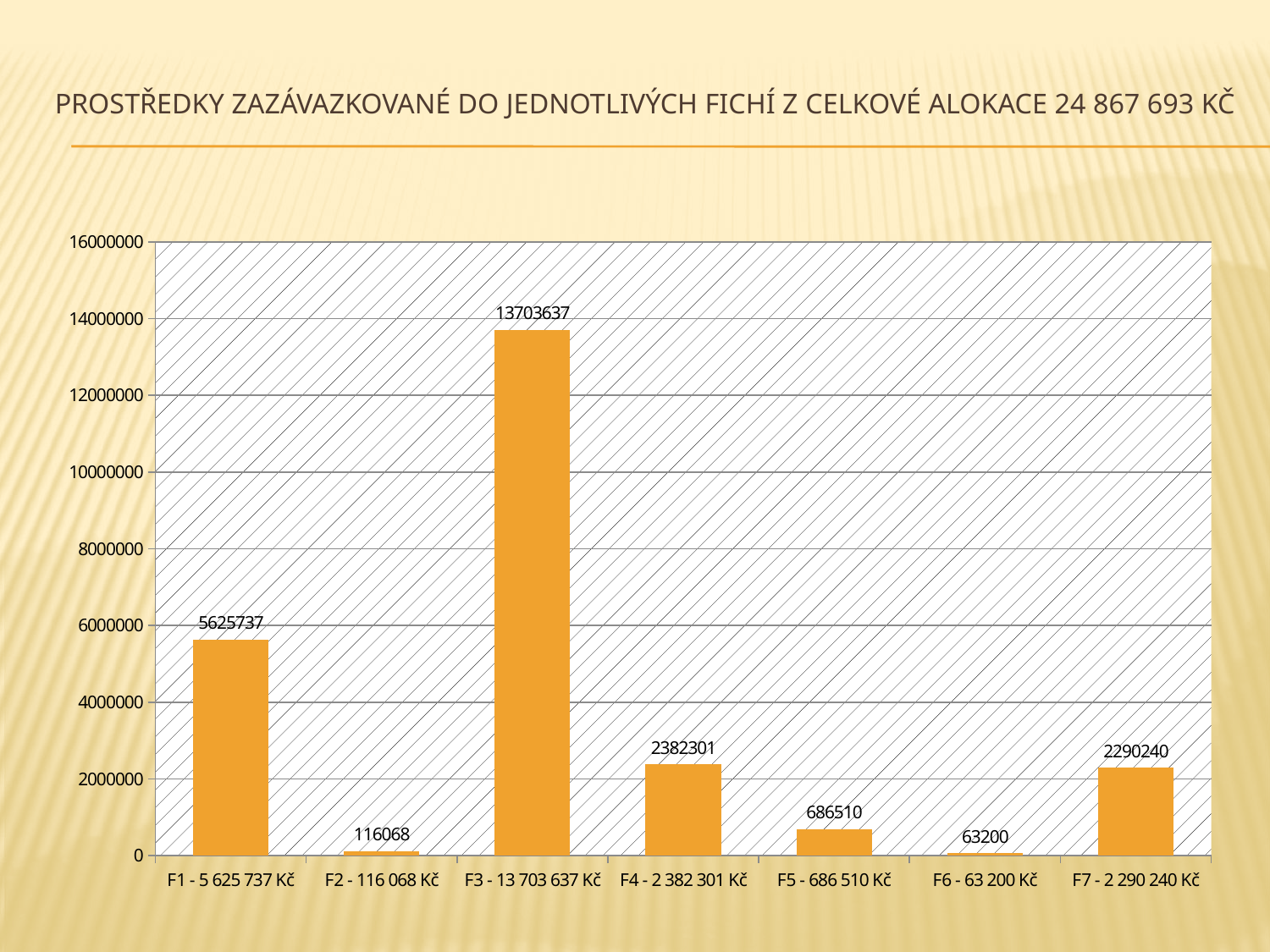
Which is larger, the value for F1 or the value for F4? F1 Is the value for F3 greater or less than 12000000? greater What kind of chart is shown on the slide? bar chart What is the value of the bar for F1? 5625737 What is the value of the bar for F5? 686510 Which category has the highest bar? F3 Which category has the lowest bar? F6 What is the value of the bar for F6? 63200 What is the value of the bar for F3? 13703637 What is the difference between the values for F4 and F7? 92061 How many bars are shown in the chart? 7 What total allocation is stated in the slide title? 24 867 693 Kč